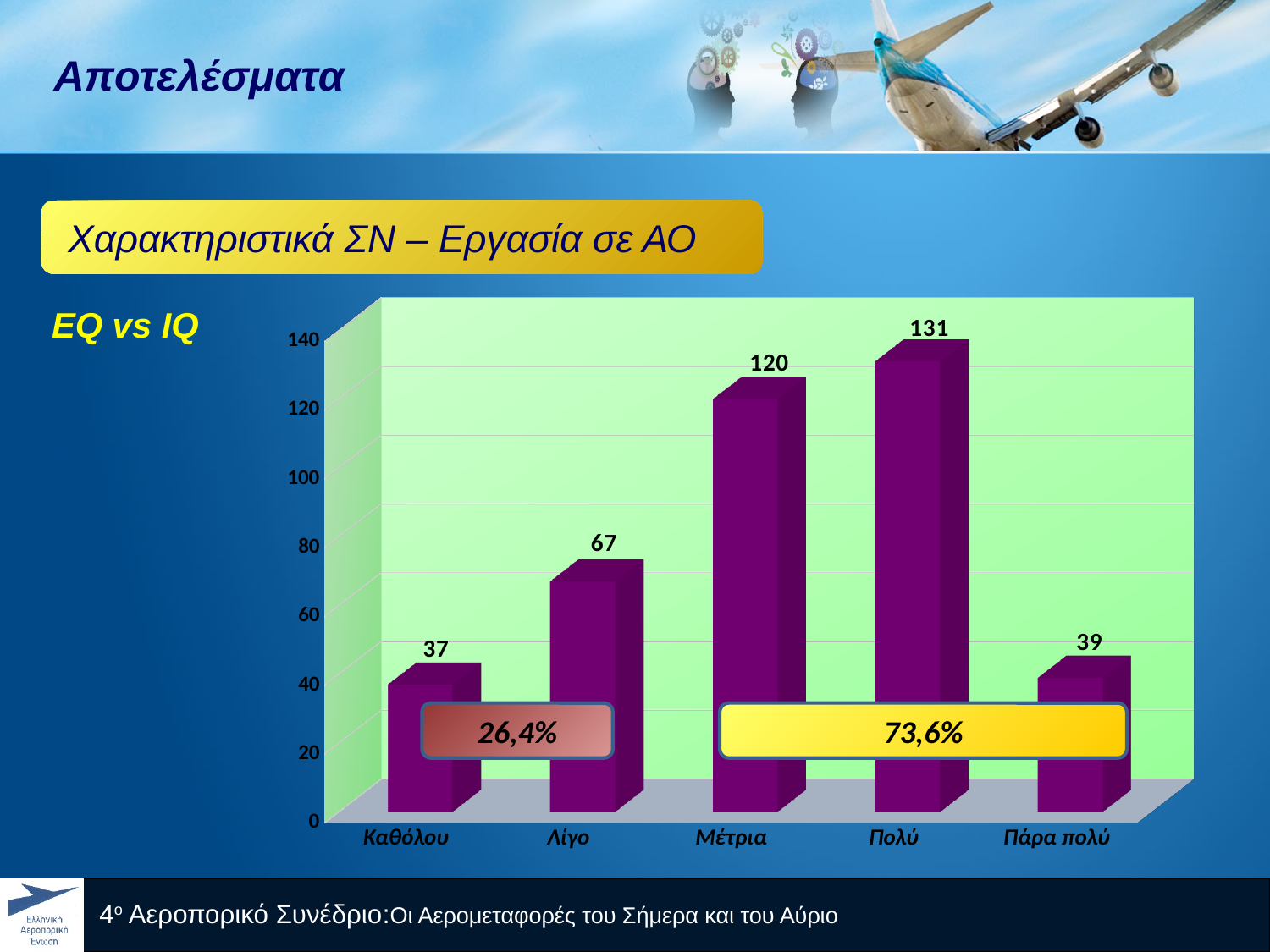
What is the value for Πάρα πολύ? 39 What is the difference between the values for Λίγο and Καθόλου? 30 What percentage is shown in the red box over the Καθόλου and Λίγο bars? 26,4% What is the value for Μέτρια? 120 Which is larger, the value for Λίγο or the value for Πάρα πολύ? Λίγο What percentage is shown in the yellow box over the Μέτρια, Πολύ and Πάρα πολύ bars? 73,6% How many categories are shown on the x axis? 5 Which category has the highest value? Πολύ Which category has the lowest value? Καθόλου What is the value for Καθόλου? 37 What is the difference between the values for Πολύ and Μέτρια? 11 What kind of chart is shown? bar chart